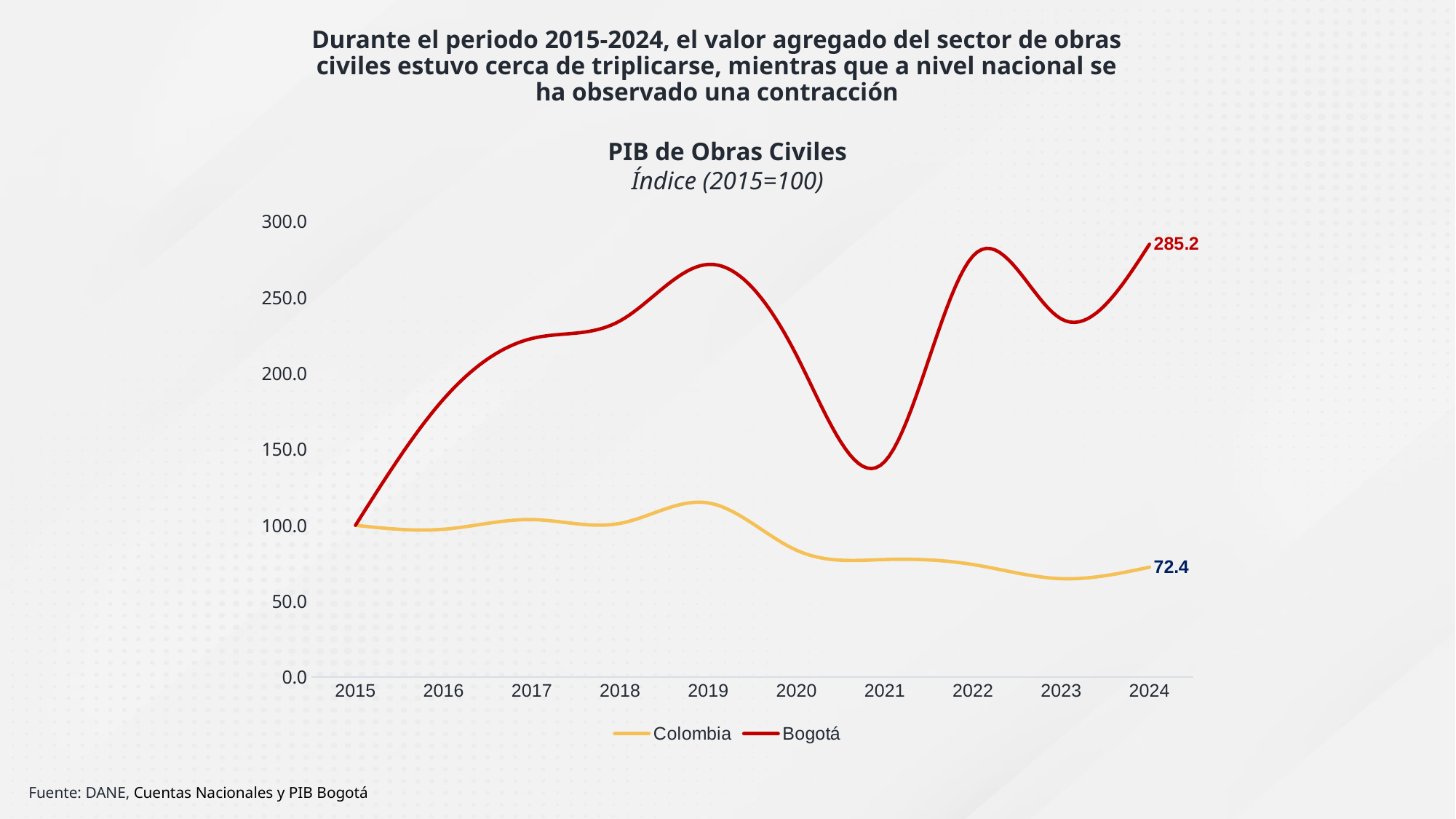
In which year does the Colombia series reach its highest value? 2019 What is the difference between the Bogotá and Colombia values in 2024? 212.8 What is the value of the Bogotá series in 2024? 285.2 What kind of chart is shown on the slide? line chart How many years are shown on the x axis of the chart? 10 Is the value for Bogotá in 2019 greater or less than 250? greater How many series does the legend list? 2 Does the Bogotá series rise or fall from 2015 to 2019? rise Is the value for Bogotá in 2021 greater or less than 150? less Is the value for Colombia in 2020 greater or less than 100? less What is the value of the Colombia series in 2024? 72.4 In 2024, which series has the larger value, Colombia or Bogotá? Bogotá